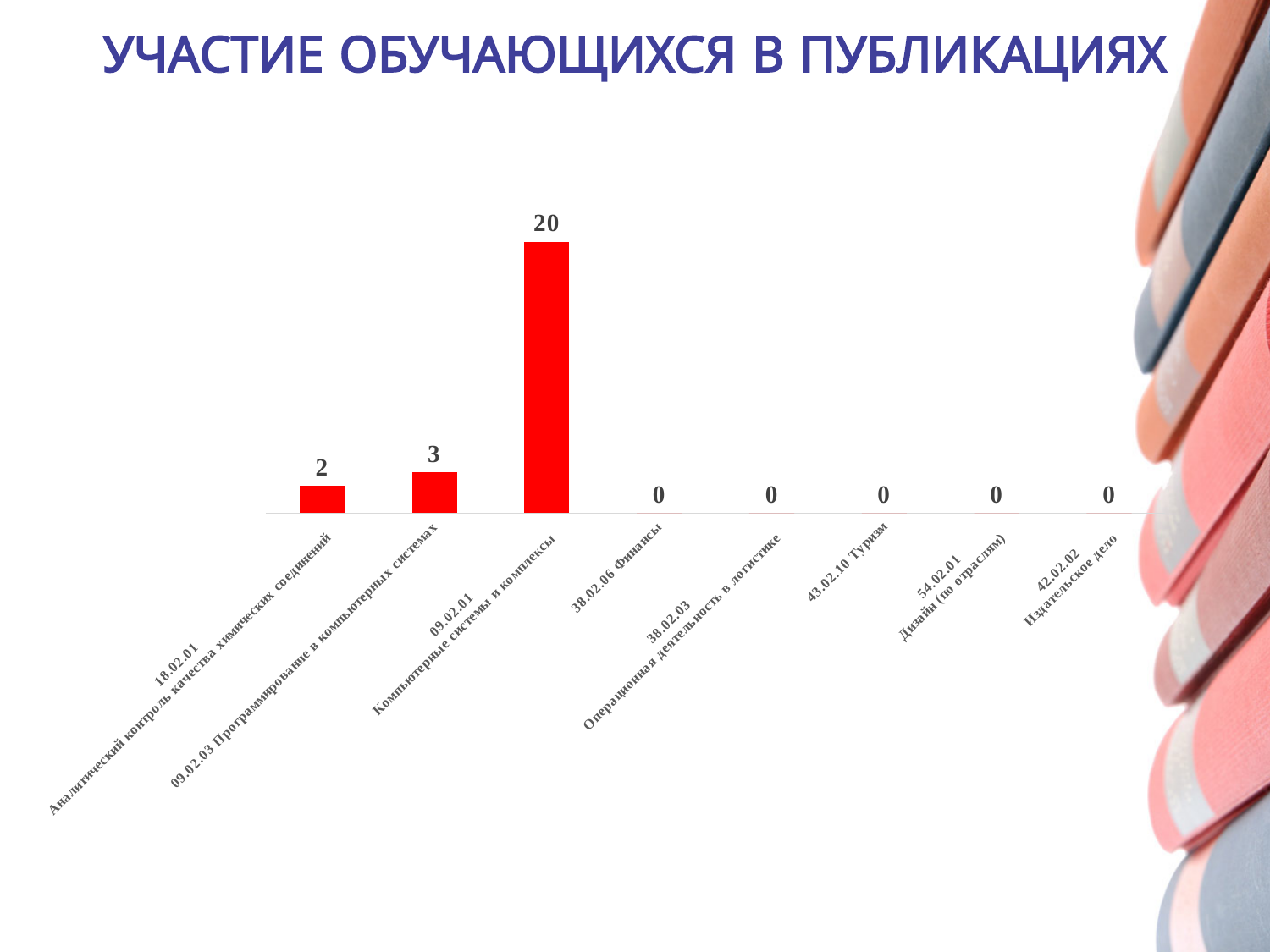
What kind of chart is shown on the slide? Bar chart What value is shown for 09.02.03 Программирование в компьютерных системах? 3 What is the difference between the values for 09.02.03 Программирование в компьютерных системах and 18.02.01 Аналитический контроль качества химических соединений? 1 Which category has the highest value? 09.02.01 Компьютерные системы и комплексы Which is larger, the value for 18.02.01 Аналитический контроль качества химических соединений or for 09.02.03 Программирование в компьютерных системах? 09.02.03 Программирование в компьютерных системах What value is shown for 43.02.10 Туризм? 0 What value is shown for 09.02.01 Компьютерные системы и комплексы? 20 What value is shown for 18.02.01 Аналитический контроль качества химических соединений? 2 How many categories have a value of 0? 5 How many categories are shown on the x axis? 8 What is the title of the slide? УЧАСТИЕ ОБУЧАЮЩИХСЯ В ПУБЛИКАЦИЯХ What is the difference between the values for 09.02.01 Компьютерные системы и комплексы and 09.02.03 Программирование в компьютерных системах? 17